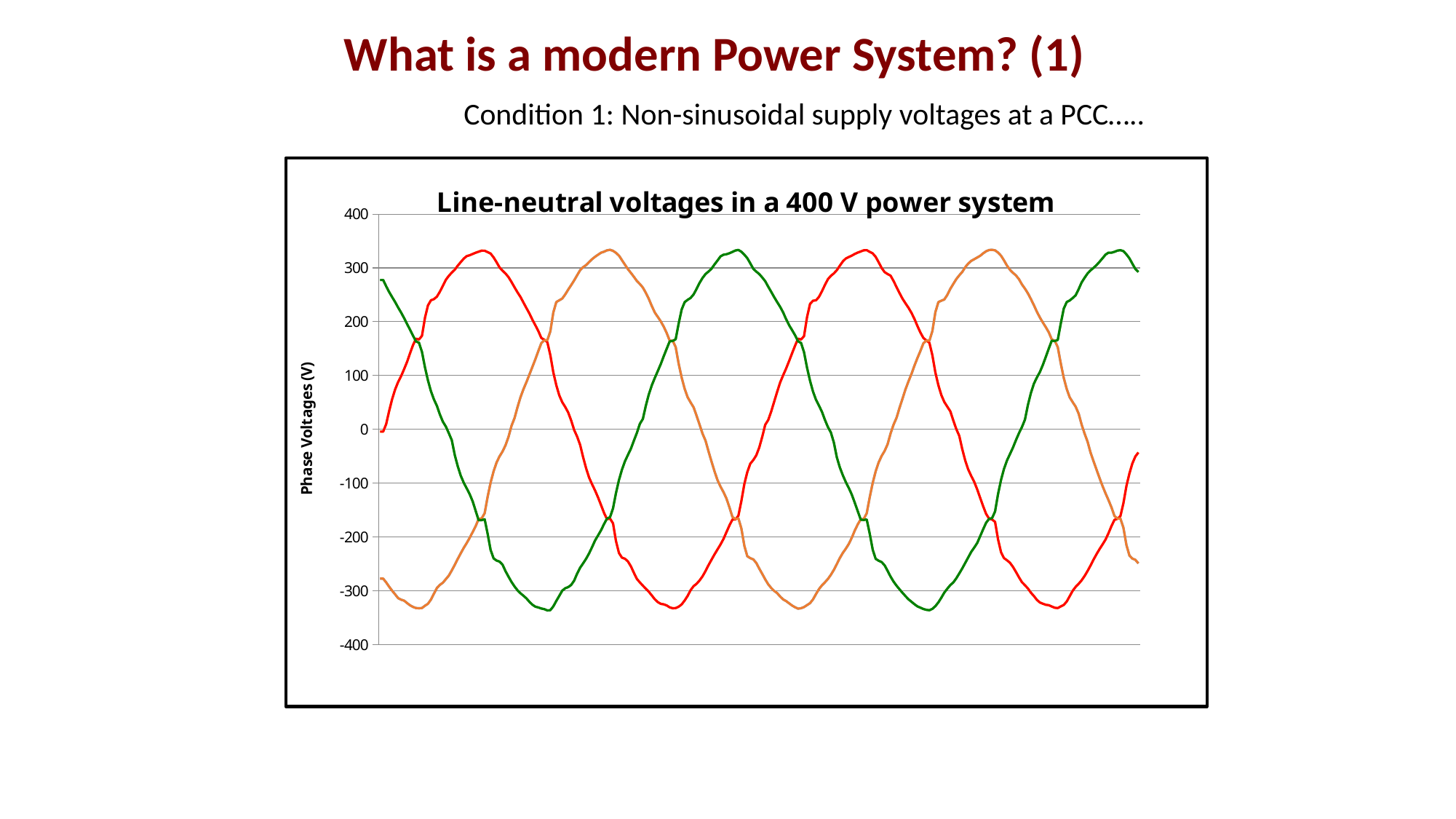
Is the peak value of the orange line greater or less than 400? less Is the lowest value of the orange line greater or less than -200? less What is the title of the chart? Line-neutral voltages in a 400 V power system Is the peak value of the green line greater or less than 200? greater What is the highest tick value shown on the vertical axis? 400 How many lines (voltage waveforms) are plotted on the chart? 3 What kind of chart is shown on the slide? line chart What is the label on the vertical axis of the chart? Phase Voltages (V)